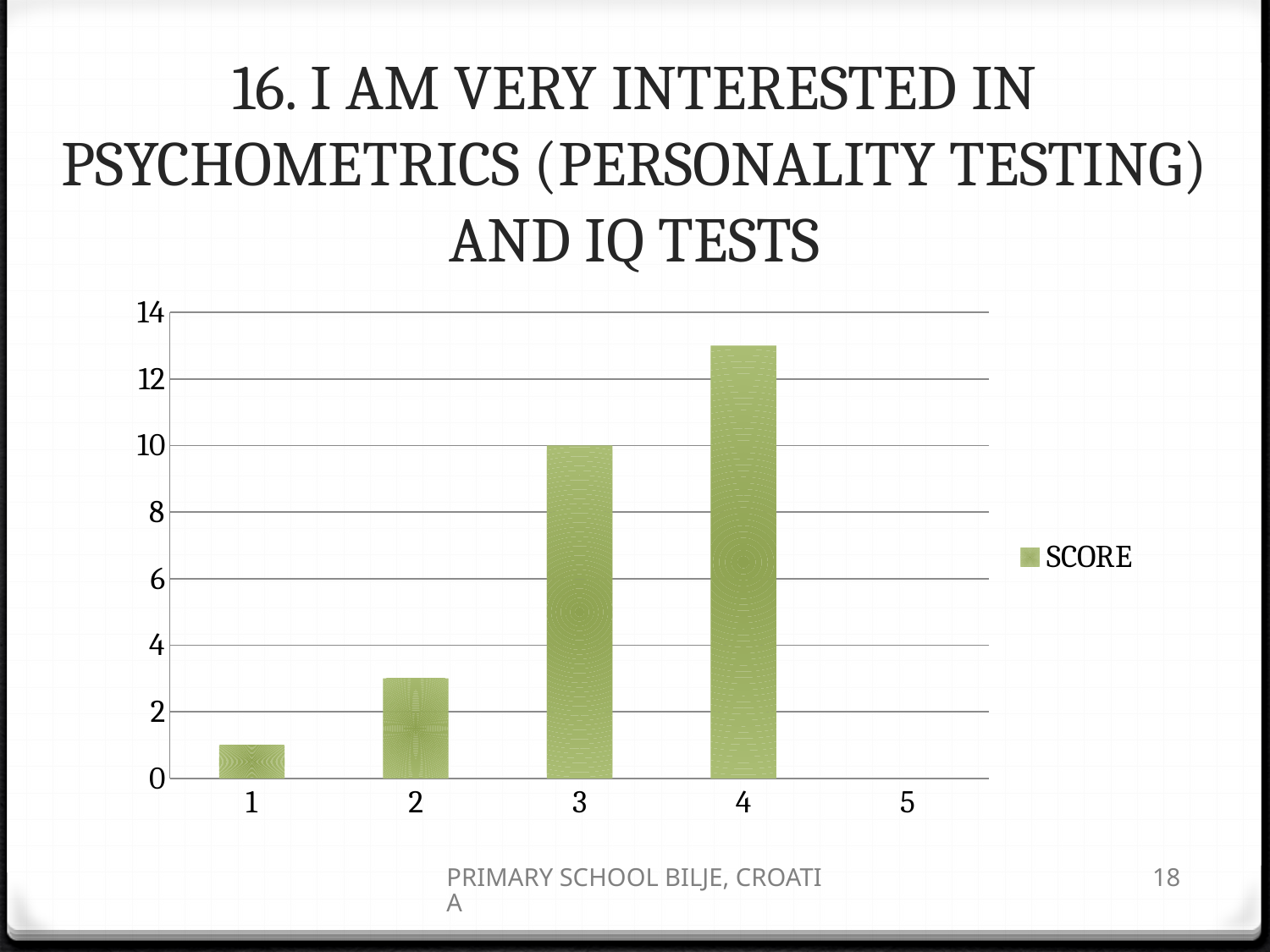
Which category has the lowest value? 5 Do the values rise or fall from category 1 to category 4? rise How many categories are shown on the x axis? 5 Is the value for category 1 greater or less than 2? less What is the value for category 3? 10 What is the value for category 5? 0 Is the value for category 2 greater or less than 4? less Which has the larger value, category 3 or category 4? 4 Which category has the highest value? 4 What kind of chart is shown on the slide? bar chart Is the value for category 4 greater or less than 12? greater How many series does the legend list? 1